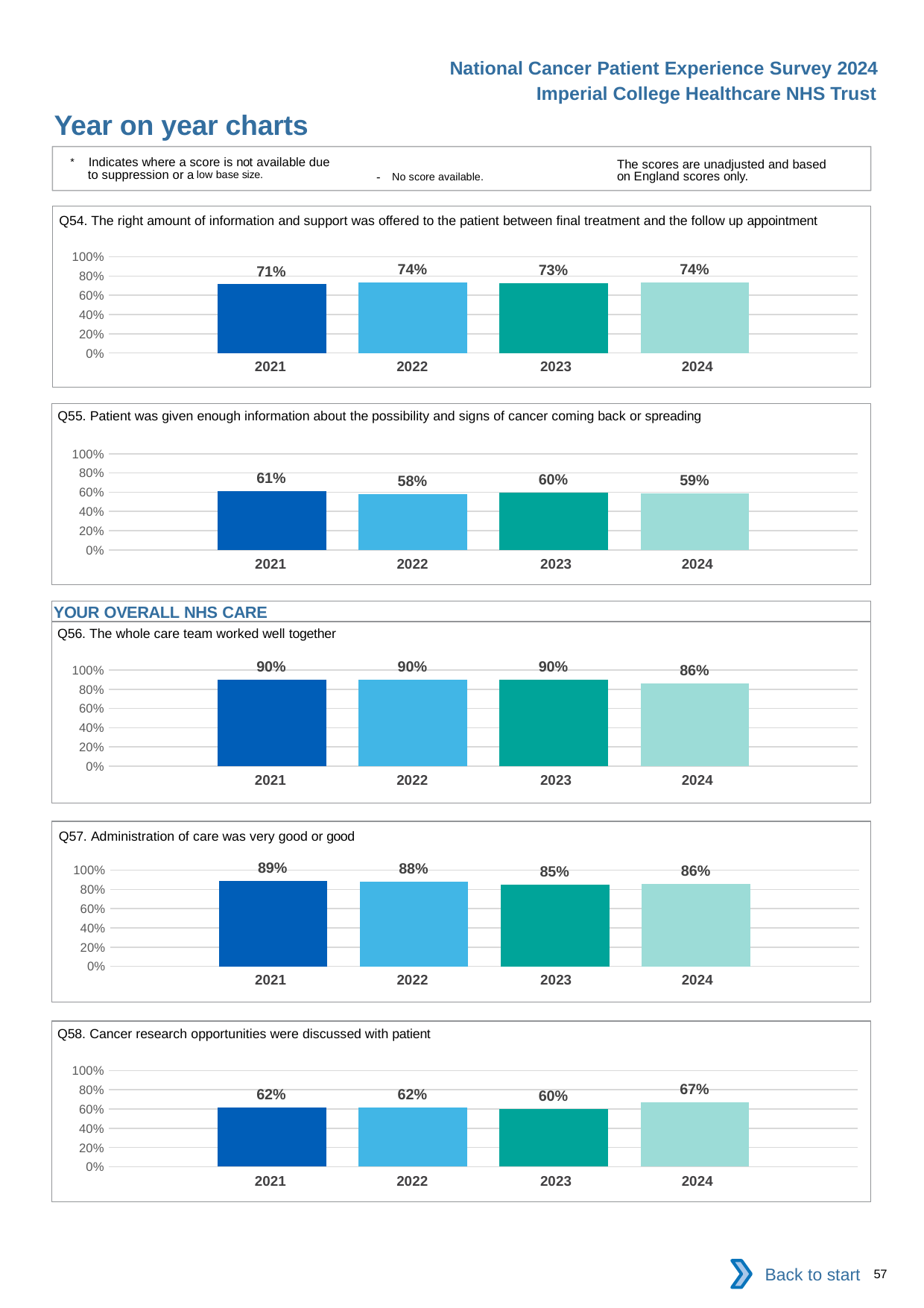
What kind of chart is the Q54 chart? bar chart In the Q58 chart, what is the value for 2024? 67% In the Q55 chart, which year has the highest value? 2021 In the Q56 chart, is the value for 2024 greater or less than 80%? greater In the Q58 chart, which year has the lowest value? 2023 In the Q55 chart, which year has the lowest value? 2022 In the Q57 chart, what is the difference between the 2021 value and the 2024 value? 3% In the Q56 chart, what is the difference between the 2023 value and the 2024 value? 4% In the Q54 chart, what is the value for 2021? 71% In the Q57 chart, which is larger, the value for 2021 or the value for 2023? 2021 How many years are shown in the Q57 chart? 4 What is the title of the chart directly below the heading 'YOUR OVERALL NHS CARE'? Q56. The whole care team worked well together